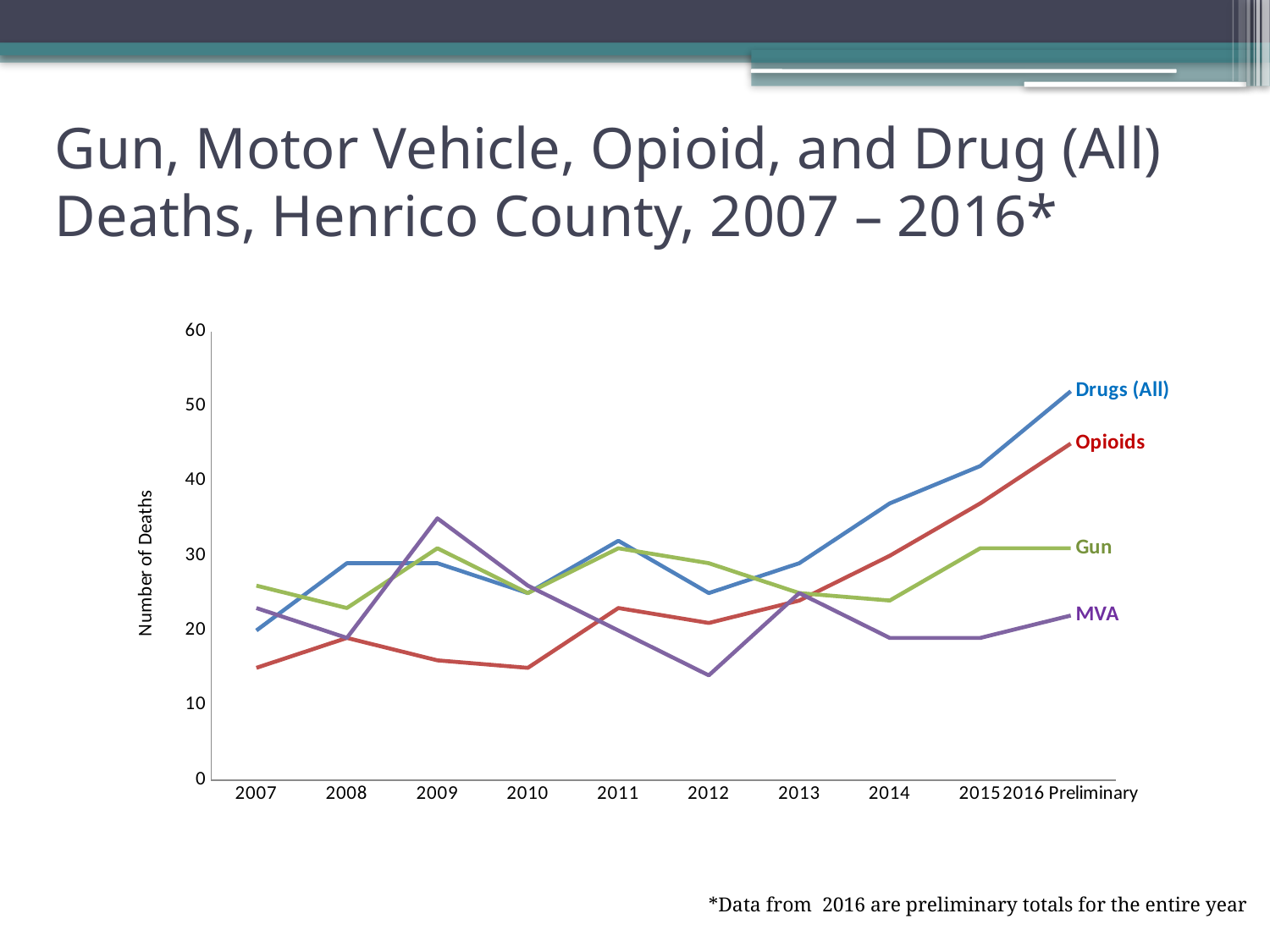
How many years are shown along the x axis of the chart? 10 Is the value for Gun in 2009 greater or less than 20? greater Which series has the highest value in 2016 Preliminary? Drugs (All) Is the value for MVA in 2012 greater or less than 20? less In 2009, which is larger: the value for MVA or the value for Opioids? MVA What kind of chart is shown on the slide? line chart What is the label on the y axis of the chart? Number of Deaths Which series has the lowest value in 2007? Opioids How many series are plotted on the chart? 4 Is the value for Opioids in 2007 greater or less than 20? less Do the Opioids values rise or fall from 2013 to 2016 Preliminary? rise